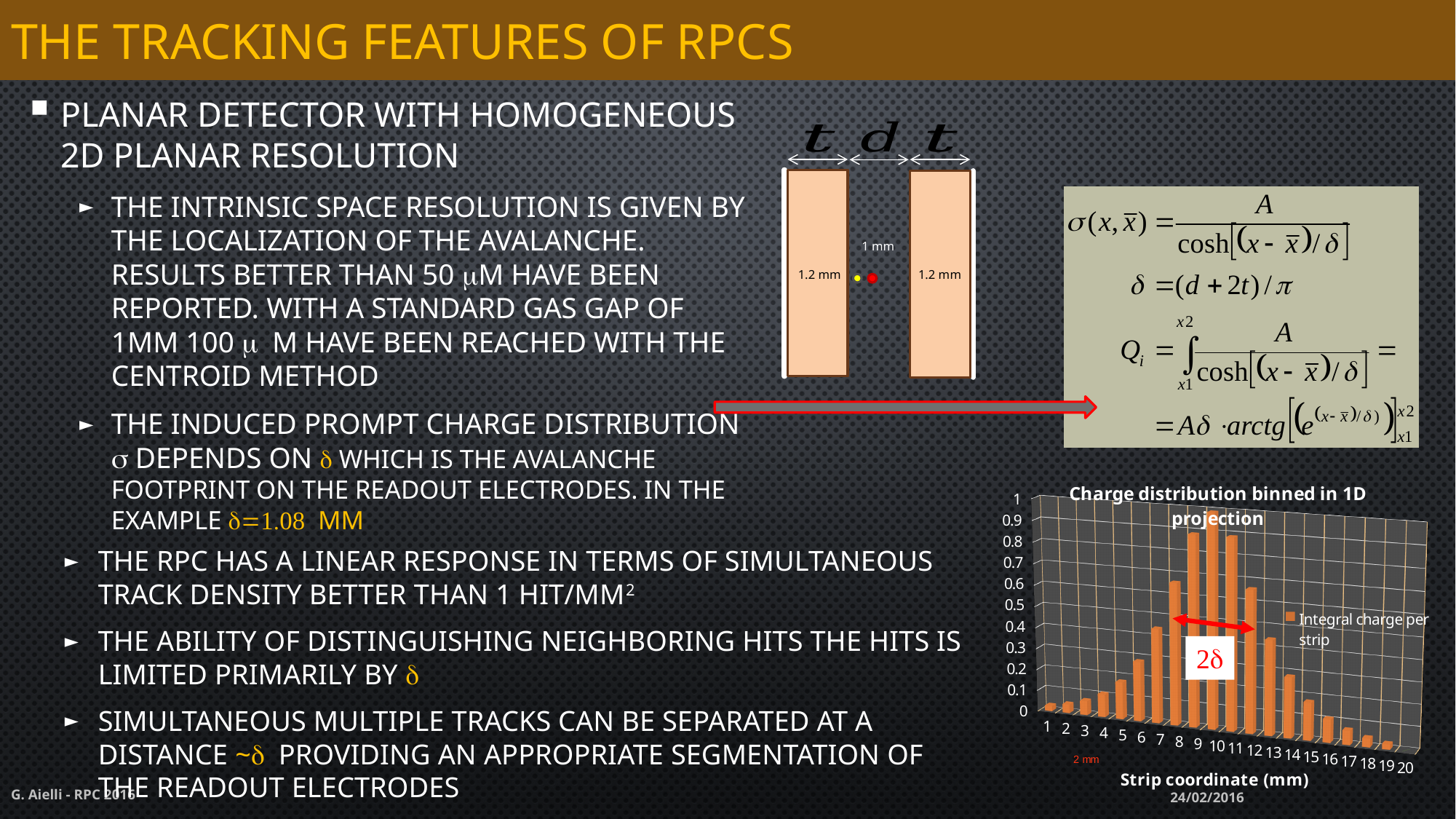
What is the x-axis label of the chart? Strip coordinate (mm) How many series does the chart legend list? 1 What kind of chart is shown on the slide? bar chart Which has a larger integral charge per strip, strip 10 or strip 5? strip 10 Is the value for strip 7 greater or less than 0.5? less What is the title of the chart on the slide? Charge distribution binned in 1D projection Is the value for strip 10 greater or less than 0.5? greater How many strip coordinate categories are plotted on the x axis of the chart? 20 Is the value for strip 1 greater or less than 0.1? less Do the values rise or fall along the x axis from strip 10 to strip 20? fall Which strip coordinate has the highest integral charge per strip? 10